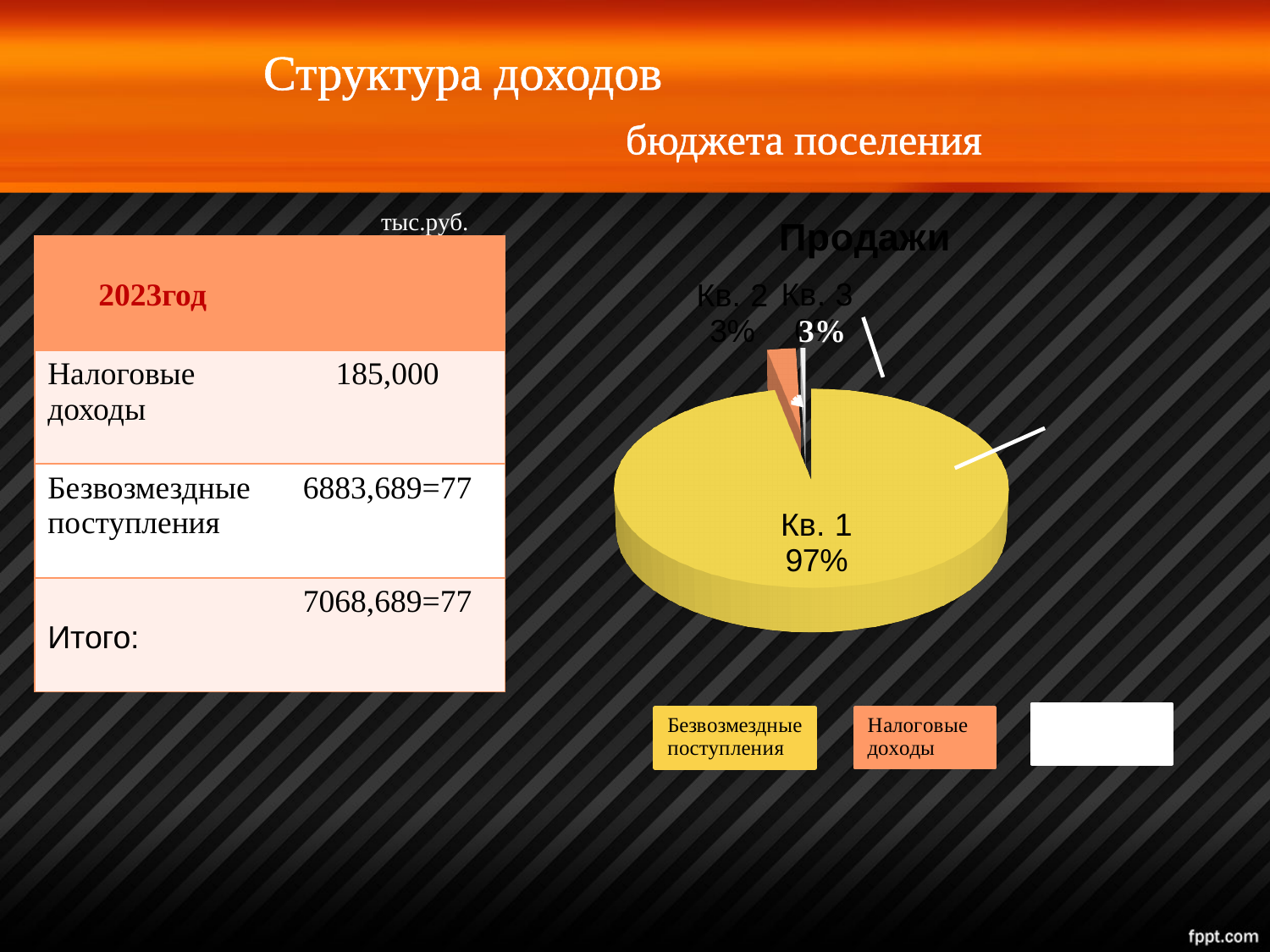
What is the difference in percentage points between the Кв. 1 slice and the Кв. 2 slice? 94 percentage points Which slice of the pie chart is the largest? Кв. 1 Which legend entry below the pie chart is shown in yellow? Безвозмездные поступления What kind of chart is shown on the slide? pie chart Which is larger in the pie chart, the slice for Кв. 1 or the slice for Кв. 2? Кв. 1 What share of the pie does the slice labelled Кв. 3 represent? 3% What share of the pie does the slice labelled Кв. 2 represent? 3% How many slices does the pie chart have? 3 Is the share of the Кв. 1 slice greater or less than 50%? greater What is the title of the pie chart? Продажи What share of the pie does the slice labelled Кв. 1 represent? 97%